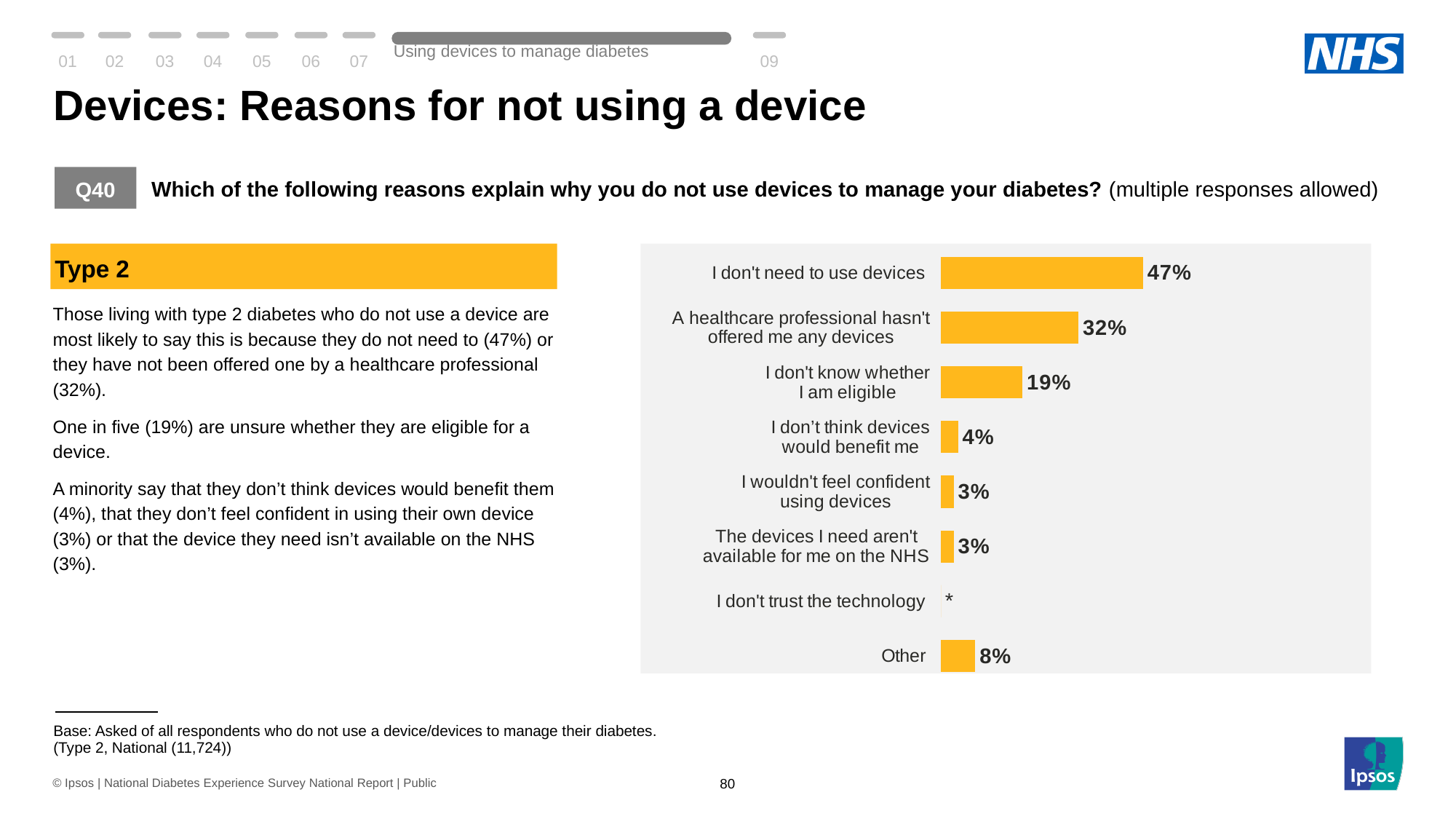
What is the value shown for "Other"? 8% What percentage said "I don't know whether I am eligible"? 19% Which is larger: "I don't know whether I am eligible" or "Other"? I don't know whether I am eligible How many reason categories are listed in the chart? 8 What type of chart is shown on the slide? Bar chart What is the difference between "I don't think devices would benefit me" and "I wouldn't feel confident using devices"? 1 percentage point Which reason has the highest percentage? I don't need to use devices What colour are the bars in the chart? Yellow/orange What is the difference between "I don't need to use devices" and "A healthcare professional hasn't offered me any devices"? 15 percentage points What percentage of respondents said "I don't need to use devices"? 47% What symbol is shown instead of a value for "I don't trust the technology"? * What is the value for "A healthcare professional hasn't offered me any devices"? 32%